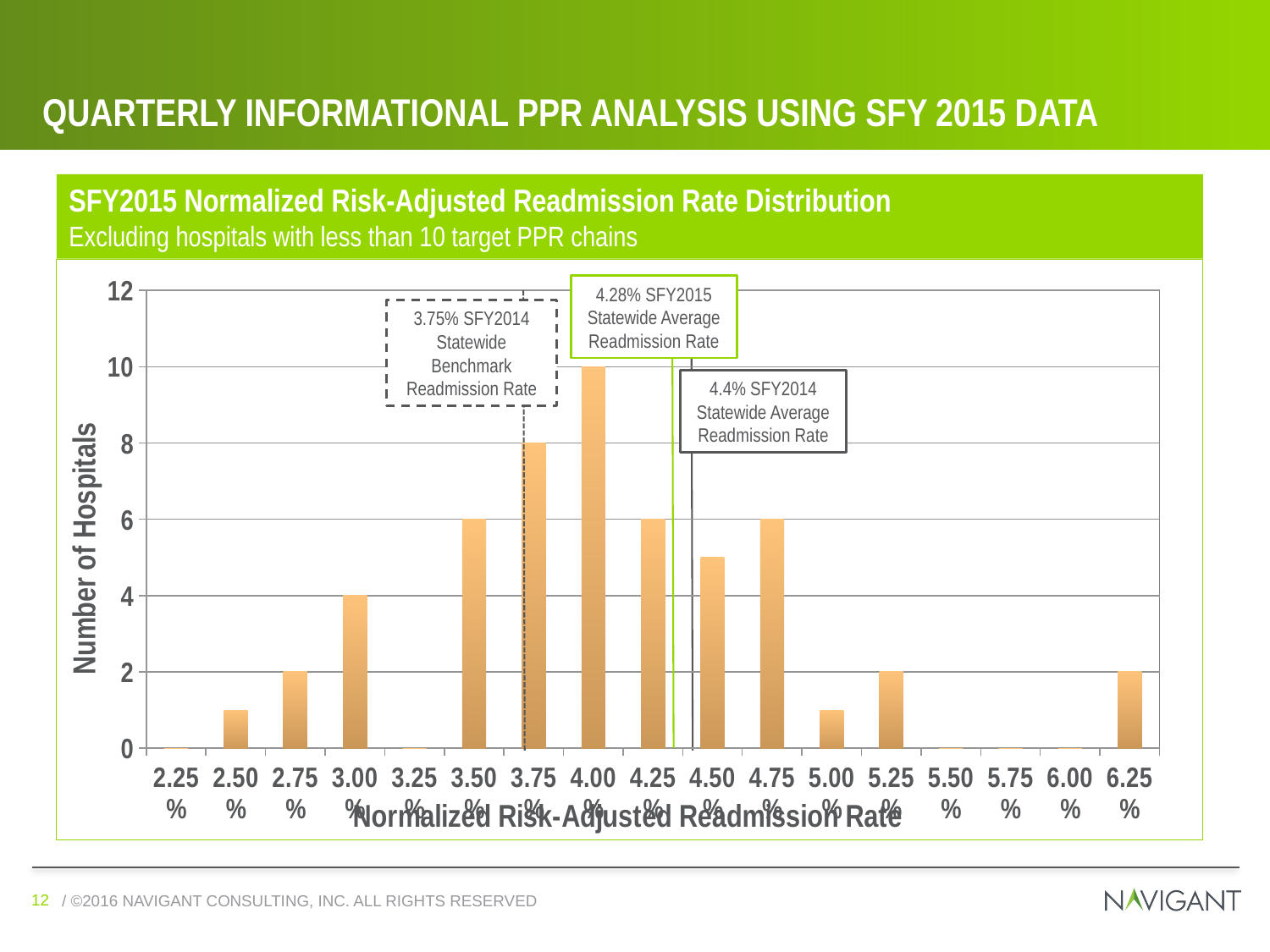
How many hospitals fall in the 3.00% readmission rate category? 4 How many hospitals fall in the 6.25% readmission rate category? 2 What kind of chart is shown on the slide? bar chart Which category has more hospitals, 3.75% or 4.50%? 3.75% How many hospitals have a normalized risk-adjusted readmission rate of 4.00%? 10 Is the number of hospitals in the 4.50% category greater or less than 4? greater What is the title of the y axis? Number of Hospitals How many readmission rate categories are shown on the x axis? 17 What is the SFY2015 statewide average readmission rate noted on the chart? 4.28% How many hospitals fall in the 3.75% readmission rate category? 8 What is the difference in the number of hospitals between the 4.00% and 3.75% categories? 2 Which readmission rate category has the highest number of hospitals? 4.00%